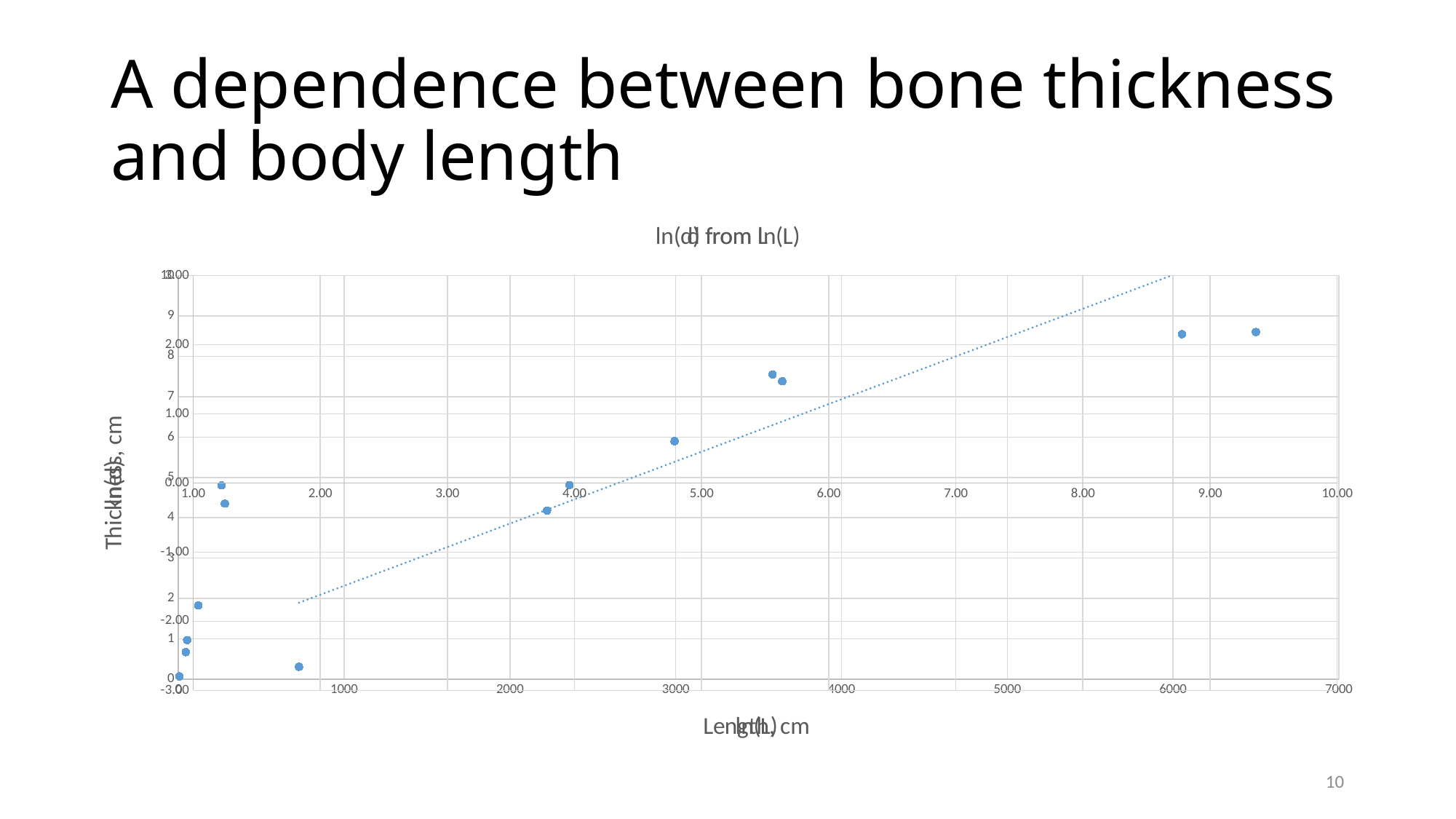
What kind of chart is shown on the slide? scatter chart What colour are the plotted data points? blue What is the title of the chart that uses the axes labelled ln(L) and ln(d)? ln(d) from ln(L) Is the rightmost plotted point, read on the horizontal axis running from 0 to 7000, greater or less than 6000? greater How many data points are plotted on the chart? 14 Do the plotted points generally rise or fall as you move from left to right along the x axis? rise Does the dotted trend line slope upward or downward from left to right? upward Is the rightmost plotted point, read on the vertical axis running from 0 to 10, greater or less than 8? greater